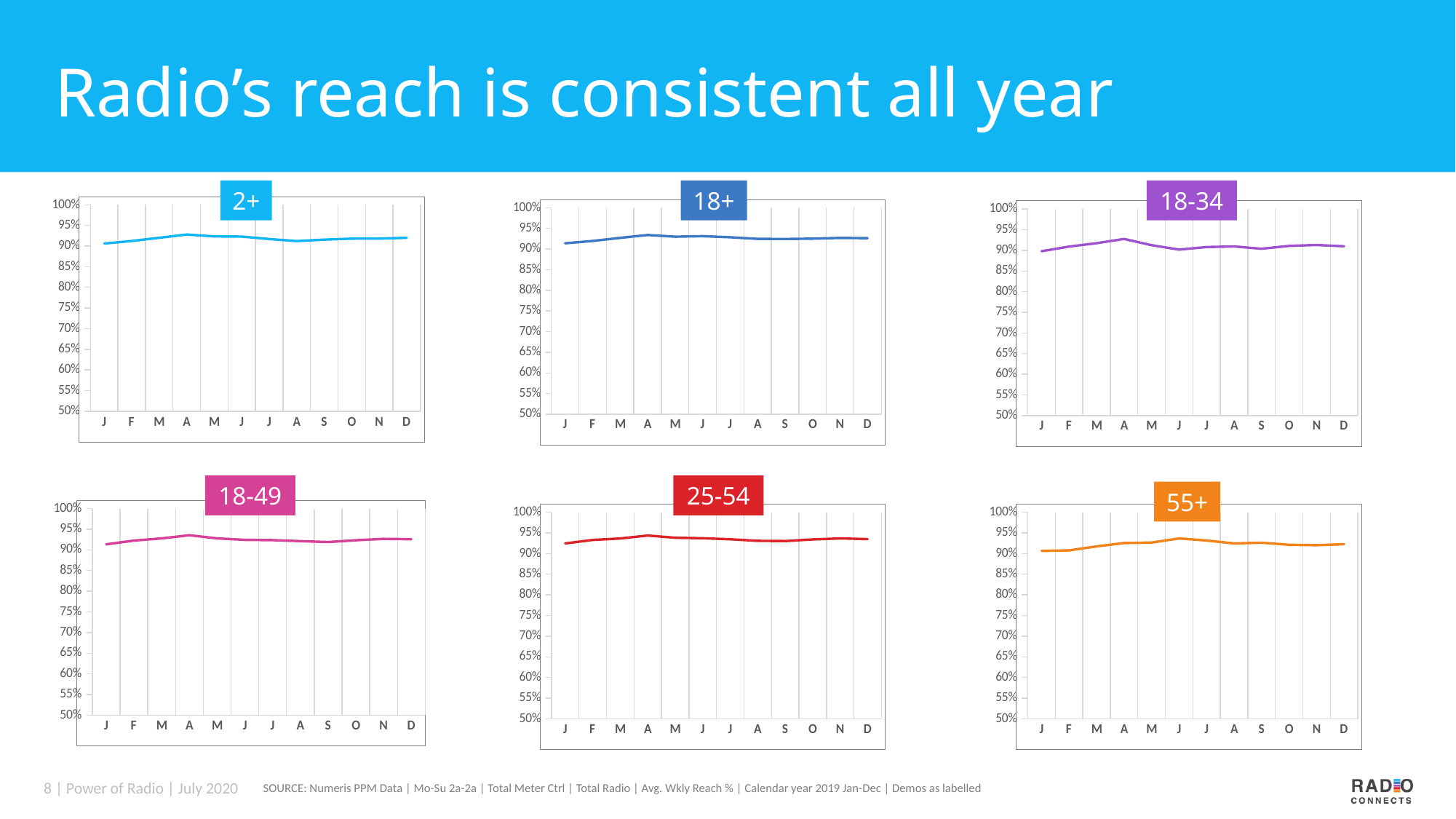
In the 25-54 chart, is the value for December greater or less than 90%? greater In the 18+ chart, how many monthly data points are plotted? 12 What colour is the line in the 25-54 chart? red What kind of chart is the 2+ chart? line chart In the 2+ chart, is the value for April greater or less than 85%? greater In the 55+ chart, is the value for June greater or less than 100%? less How many charts are shown on the slide? 6 In the 18-34 chart, which month has the highest value? A (April) In the 18+ chart, what is the lowest value shown on the vertical axis? 50% In the 55+ chart, which month has the highest value? J (June)